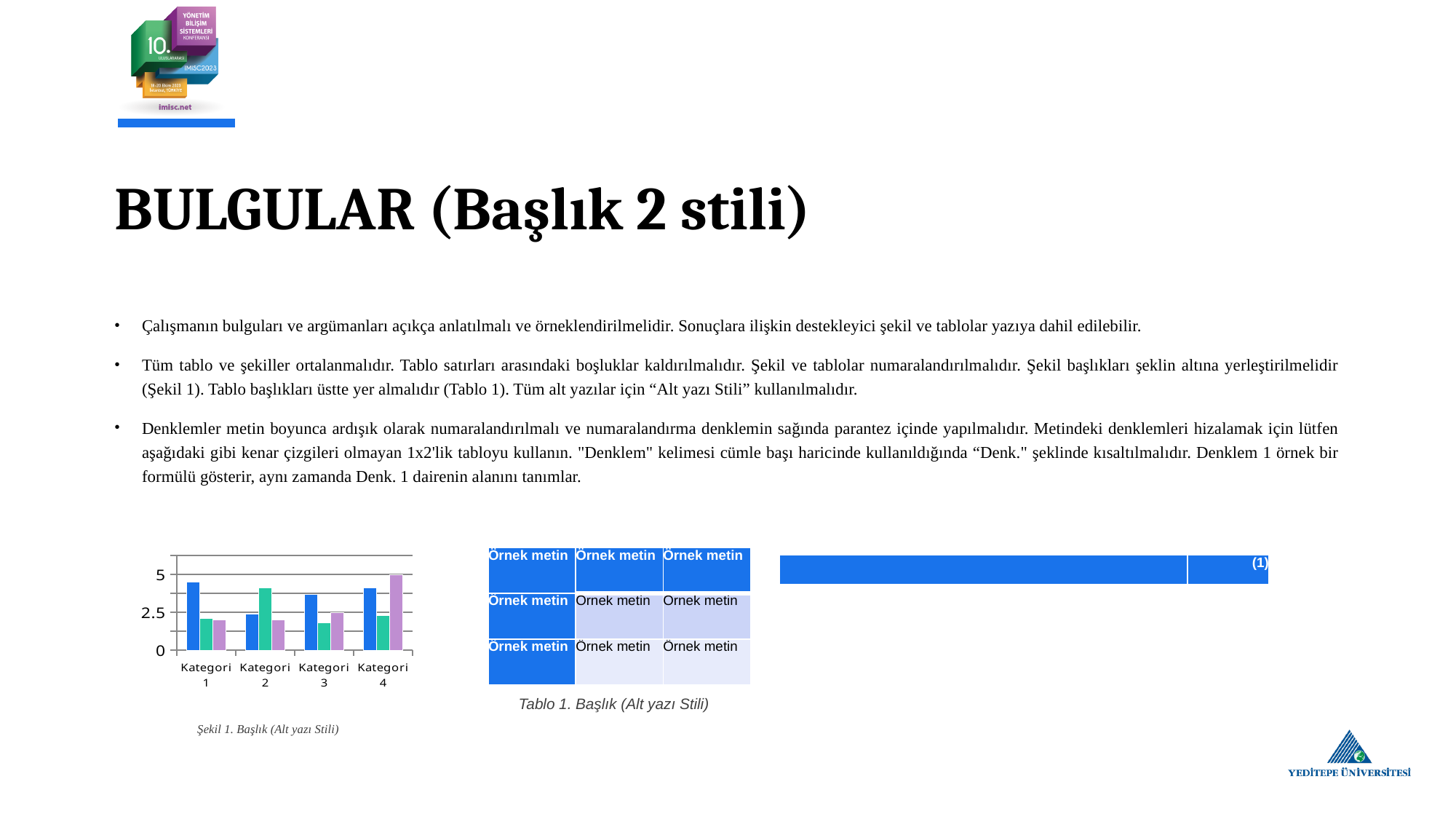
Which category contains the tallest bar in the chart? Kategori 4 What is the highest tick value shown on the y axis of the bar chart? 5 What is the caption printed below the bar chart? Şekil 1. Başlık (Alt yazı Stili) Is the value of the blue bar for Kategori 3 greater or less than 2.5? greater What kind of chart is shown in Şekil 1? bar chart Which is larger: the blue bar for Kategori 1 or the blue bar for Kategori 2? Kategori 1 Is the value of the green bar for Kategori 3 greater or less than 2.5? less Is the value of the blue bar for Kategori 1 greater or less than 2.5? greater How many categories are shown on the x axis of the bar chart? 4 How many bars are plotted for each category in the bar chart? 3 Which is larger: the green bar for Kategori 2 or the green bar for Kategori 3? Kategori 2